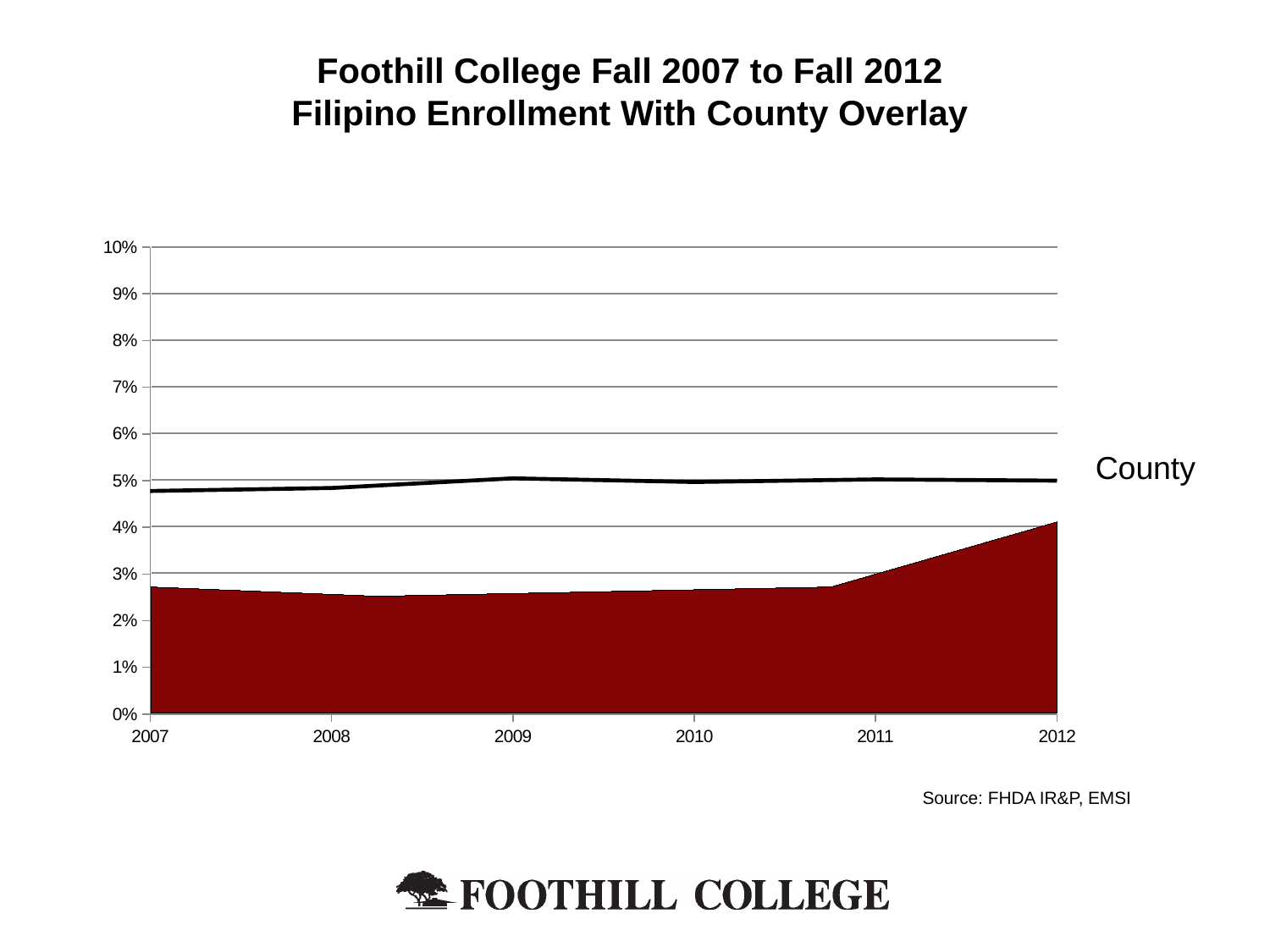
Does the Foothill College Filipino enrollment (shaded area) rise or fall from 2011 to 2012? rise What is the first year shown on the x axis? 2007 What is the last year shown on the x axis? 2012 Is the County value for 2010 greater or less than 4%? greater In 2011, which is larger: the County value or the Foothill College Filipino enrollment value? County Is the County value for 2009 greater or less than 6%? less Is the Foothill College Filipino enrollment value for 2008 greater or less than 3%? less What kind of chart is shown on the slide? area chart How many years are shown along the x axis? 6 What label is shown next to the black line on the right of the chart? County In which year is the Foothill College Filipino enrollment (shaded area) highest? 2012